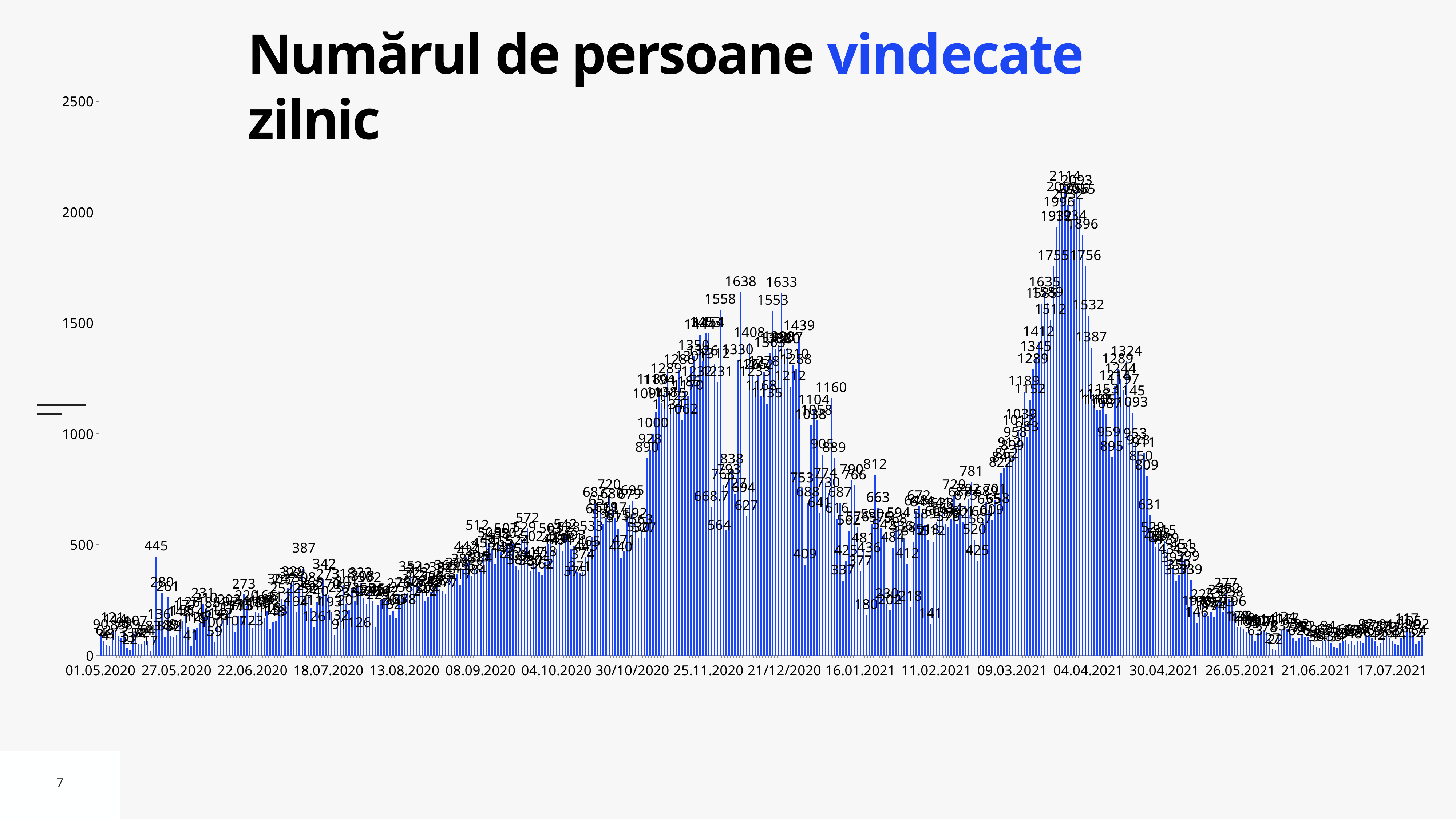
Which peak is higher: the one around 25.11.2020 or the one around 04.04.2021? 04.04.2021 What is the value of the tallest bar on the chart, at the peak near 04.04.2021? 2114 Is the value for 25.11.2020 greater or less than 1000? greater Is the value for 17.07.2021 greater or less than 500? less Do the values rise or fall between 04.04.2021 and 26.05.2021? fall What is the value of the tallest bar in the first small peak near 27.05.2020? 445 How many date labels are shown on the horizontal axis? 18 What is the title of the chart? Numărul de persoane vindecate zilnic What kind of chart is shown on the slide? bar chart Is the value for 01.05.2020 greater or less than 500? less What is the highest value shown on the vertical axis? 2500 Do the values rise or fall between 09.03.2021 and 04.04.2021? rise